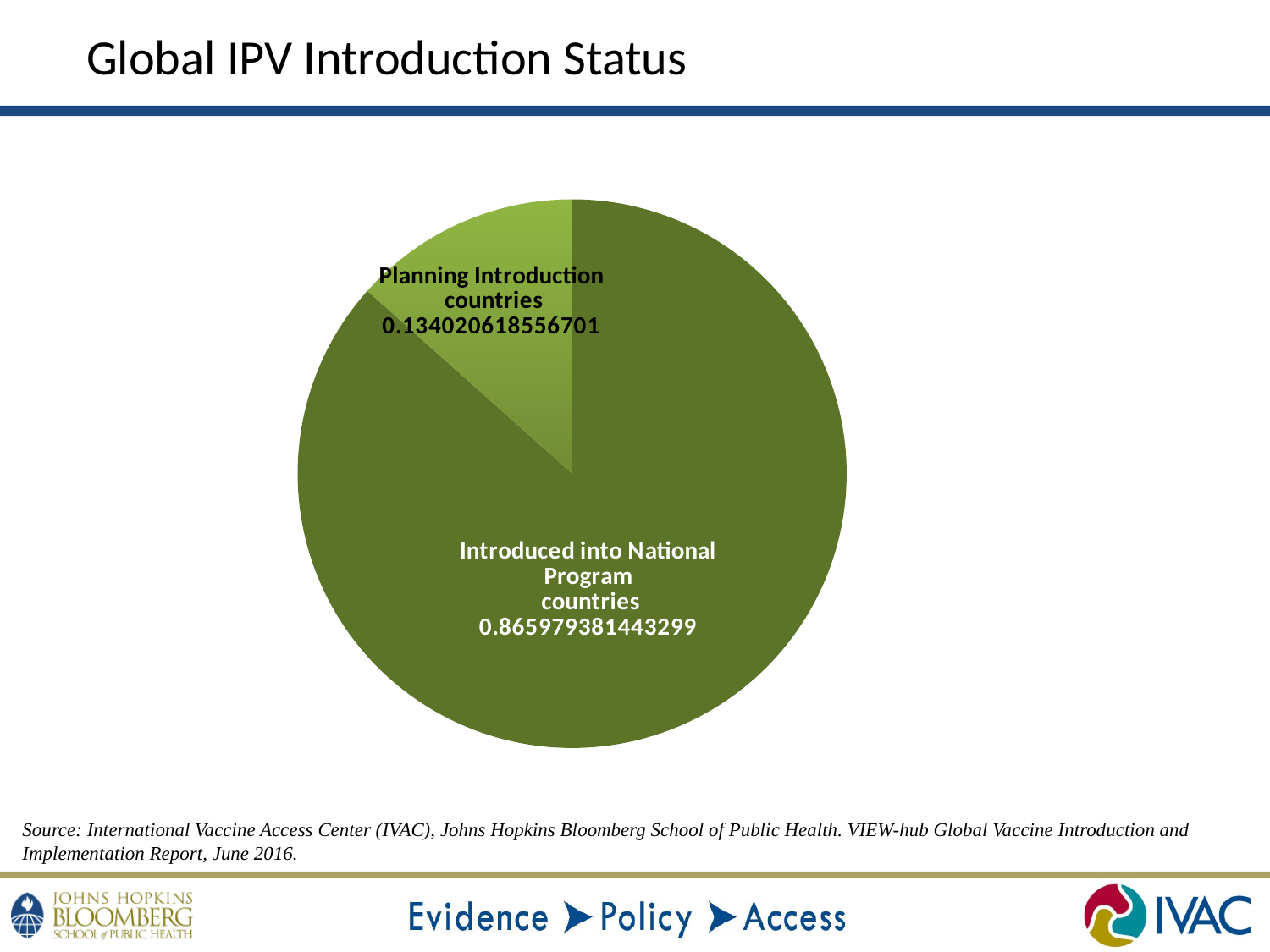
What kind of chart is shown on the slide? Pie chart What is the difference between the labelled values of the 'Introduced into National Program countries' slice and the 'Planning Introduction countries' slice? 0.731958762886598 Which is larger: the 'Introduced into National Program countries' slice or the 'Planning Introduction countries' slice? Introduced into National Program countries Which slice of the pie chart is drawn in the lighter green colour? Planning Introduction countries Which slice of the pie chart is the largest? Introduced into National Program countries Which slice of the pie chart is the smallest? Planning Introduction countries What is the title of the slide containing the pie chart? Global IPV Introduction Status How many slices does the pie chart have? 2 What value is labelled on the 'Planning Introduction countries' slice? 0.134020618556701 What value is labelled on the 'Introduced into National Program countries' slice? 0.865979381443299